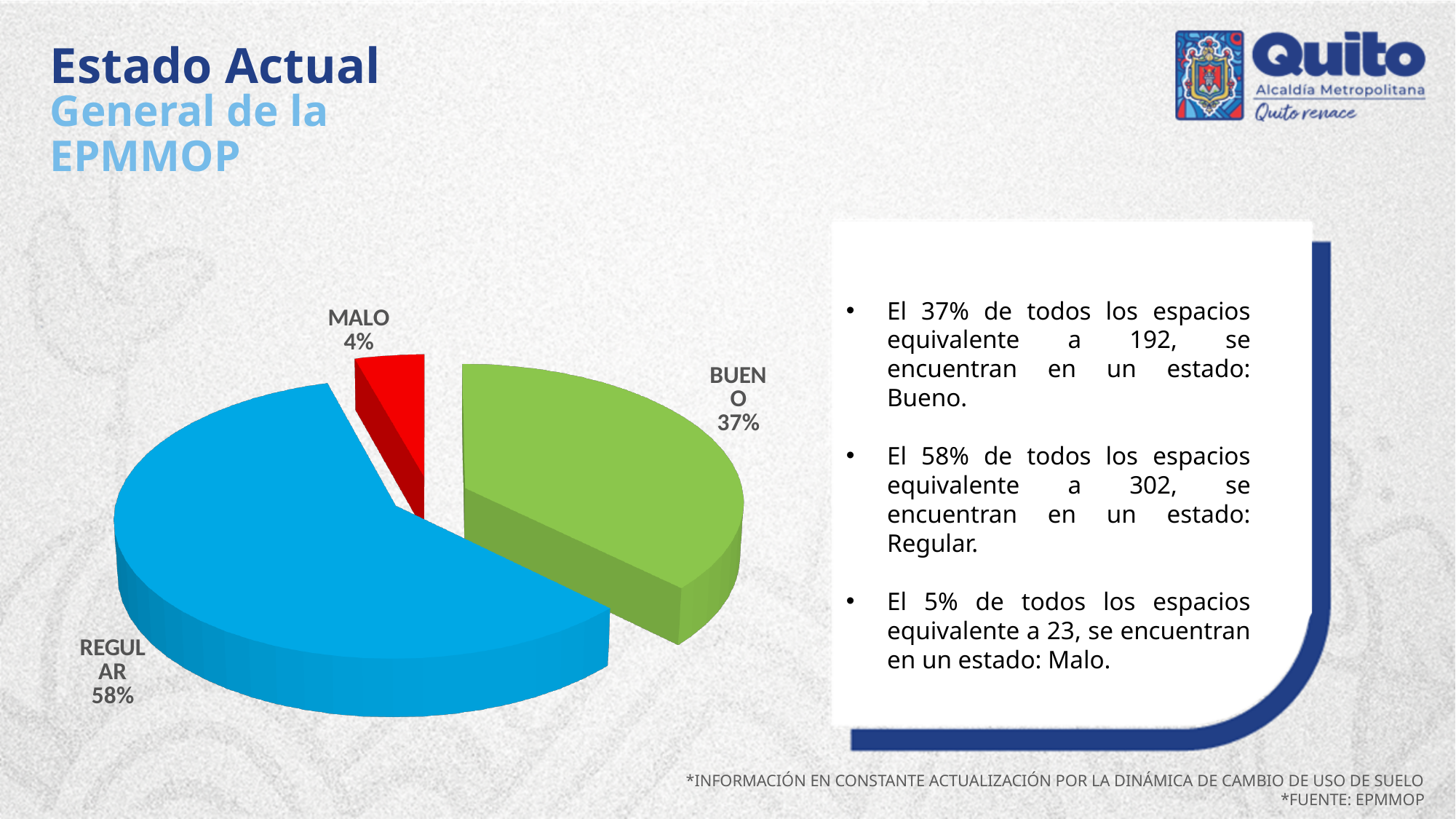
What type of chart is shown on the slide? Pie chart Which category has the smallest share of the pie? MALO How many slices does the pie chart have? 3 What is the difference in percentage points between the REGULAR and BUENO slices? 21 What percentage does the BUENO slice represent? 37% What colour is the REGULAR slice? Blue What percentage does the MALO slice represent? 4% What percentage does the REGULAR slice represent? 58% Which slice is larger, BUENO or MALO? BUENO Which category has the largest share of the pie? REGULAR What colour is the MALO slice? Red What is the difference in percentage points between the BUENO and MALO slices? 33